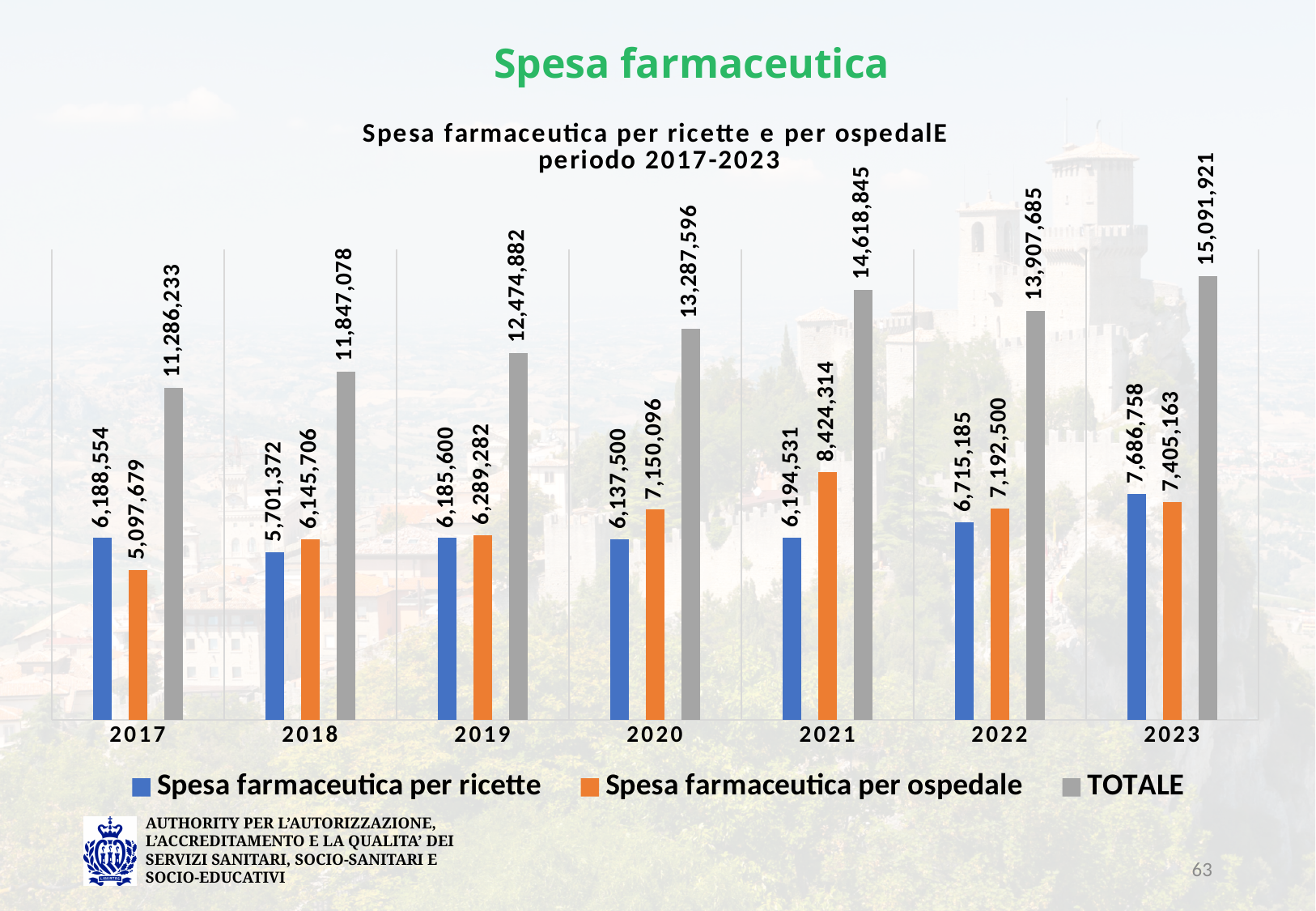
In which year is Spesa farmaceutica per ospedale highest? 2021 What kind of chart is shown on the slide? Bar chart Does Spesa farmaceutica per ospedale rise or fall from 2017 to 2021? Rise What is the TOTALE value for 2023? 15,091,921 What is the value of Spesa farmaceutica per ricette in 2017? 6,188,554 What is the value of Spesa farmaceutica per ospedale in 2020? 7,150,096 How many series does the legend list? 3 How many years are shown on the x axis? 7 In 2017, which is larger: Spesa farmaceutica per ricette or Spesa farmaceutica per ospedale? Spesa farmaceutica per ricette By how much did the TOTALE increase from 2017 to 2023? 3,805,688 What is the difference between Spesa farmaceutica per ricette and Spesa farmaceutica per ospedale in 2023? 281,595 In which year is Spesa farmaceutica per ricette lowest? 2018